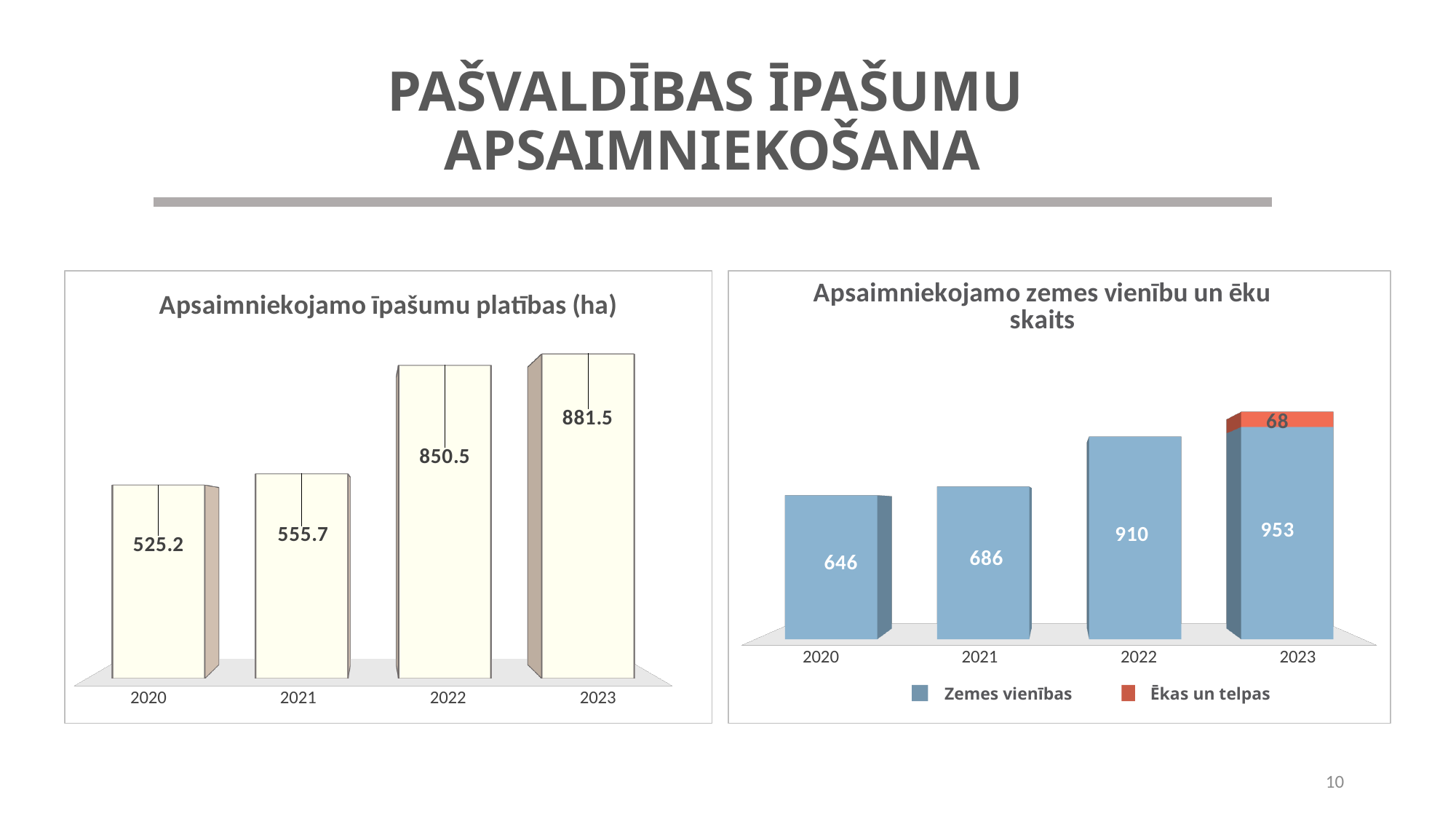
In the chart 'Apsaimniekojamo īpašumu platības (ha)', what is the difference between the 2023 and 2022 values? 31.0 In the chart 'Apsaimniekojamo īpašumu platības (ha)', what is the value for 2021? 555.7 In the chart 'Apsaimniekojamo zemes vienību un ēku skaits', is Zemes vienības larger in 2021 or in 2020? 2021 In the chart 'Apsaimniekojamo īpašumu platības (ha)', how many years are shown? 4 In the chart 'Apsaimniekojamo zemes vienību un ēku skaits', how many series does the legend list? 2 In the chart 'Apsaimniekojamo īpašumu platības (ha)', which year has the lowest value? 2020 In the chart 'Apsaimniekojamo zemes vienību un ēku skaits', what is the total of the stacked bar for 2023? 1021 In the chart 'Apsaimniekojamo zemes vienību un ēku skaits', what is the value of Zemes vienības for 2022? 910 What kind of chart is 'Apsaimniekojamo zemes vienību un ēku skaits'? bar chart In the chart 'Apsaimniekojamo zemes vienību un ēku skaits', what is the value of Ēkas un telpas for 2023? 68 In the chart 'Apsaimniekojamo īpašumu platības (ha)', which year has the highest value? 2023 In the chart 'Apsaimniekojamo īpašumu platības (ha)', do the values rise or fall from 2020 to 2023? rise